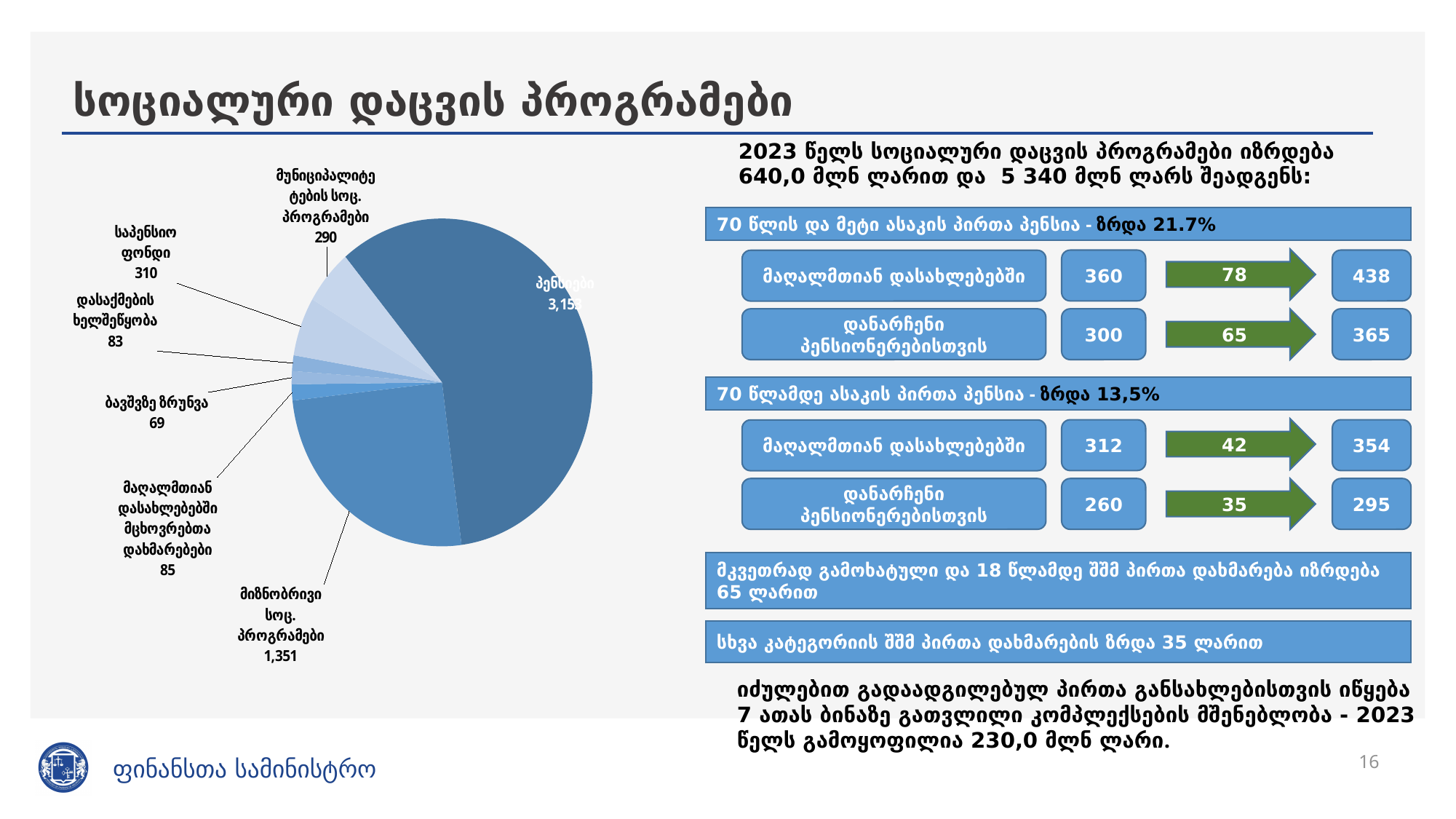
Which category has the largest slice in the pie chart? პენსიები How many slices does the pie chart have? 7 What is the value for მაღალმთიან დასახლებებში მცხოვრებთა დახმარებები in the pie chart? 85 Which is larger in the pie chart: საპენსიო ფონდი or მუნიციპალიტეტების სოც. პროგრამები? საპენსიო ფონდი What is the value for მიზნობრივი სოც. პროგრამები in the pie chart? 1,351 What is the value for საპენსიო ფონდი in the pie chart? 310 Which category has the smallest slice in the pie chart? ბავშვზე ზრუნვა What is the difference between მიზნობრივი სოც. პროგრამები and მუნიციპალიტეტების სოც. პროგრამები in the pie chart? 1,061 What kind of chart is shown on the left of the slide? pie chart What is the value for ბავშვზე ზრუნვა in the pie chart? 69 What is the value for დასაქმების ხელშეწყობა in the pie chart? 83 What is the value for მუნიციპალიტეტების სოც. პროგრამები in the pie chart? 290